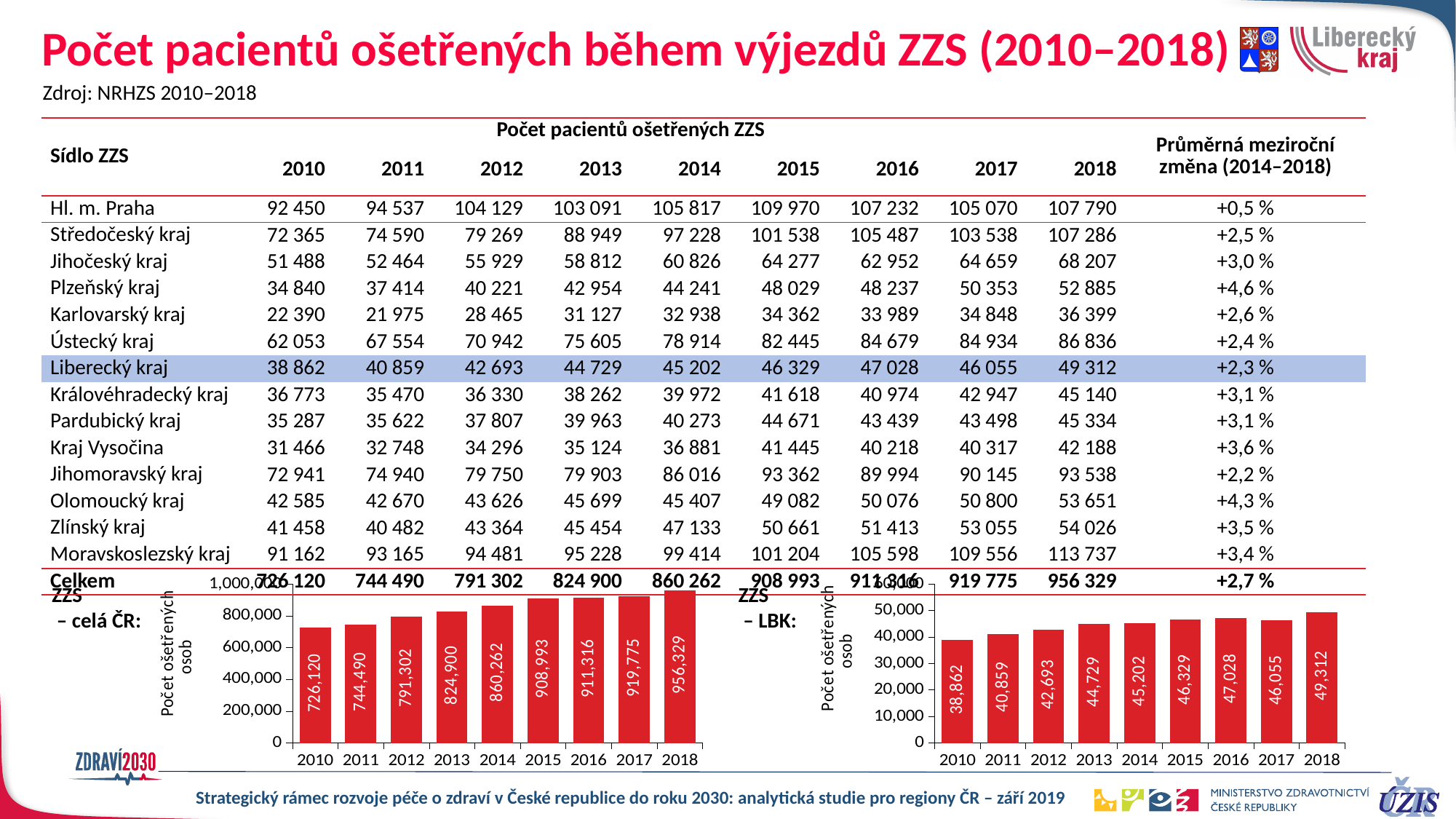
In the left chart (ZZS – celá ČR), is the value for 2015 greater or less than 800,000? greater In the left chart (ZZS – celá ČR), do the values rise or fall from 2010 to 2018? rise What is the y-axis label of the right chart (ZZS – LBK)? Počet ošetřených osob In the left chart (ZZS – celá ČR), which year has the lowest value? 2010 In the right chart (ZZS – LBK), what is the value for 2017? 46,055 In the right chart (ZZS – LBK), which year has the highest value? 2018 In the right chart (ZZS – LBK), which is larger, the value for 2016 or the value for 2017? 2016 In the left chart (ZZS – celá ČR), what is the value for 2014? 860,262 In the right chart (ZZS – LBK), what is the difference between the values for 2016 and 2017? 973 What kind of chart is the left chart (ZZS – celá ČR)? bar chart In the left chart (ZZS – celá ČR), what is the difference between the values for 2018 and 2010? 230,209 How many years are shown on the x axis of the right chart (ZZS – LBK)? 9